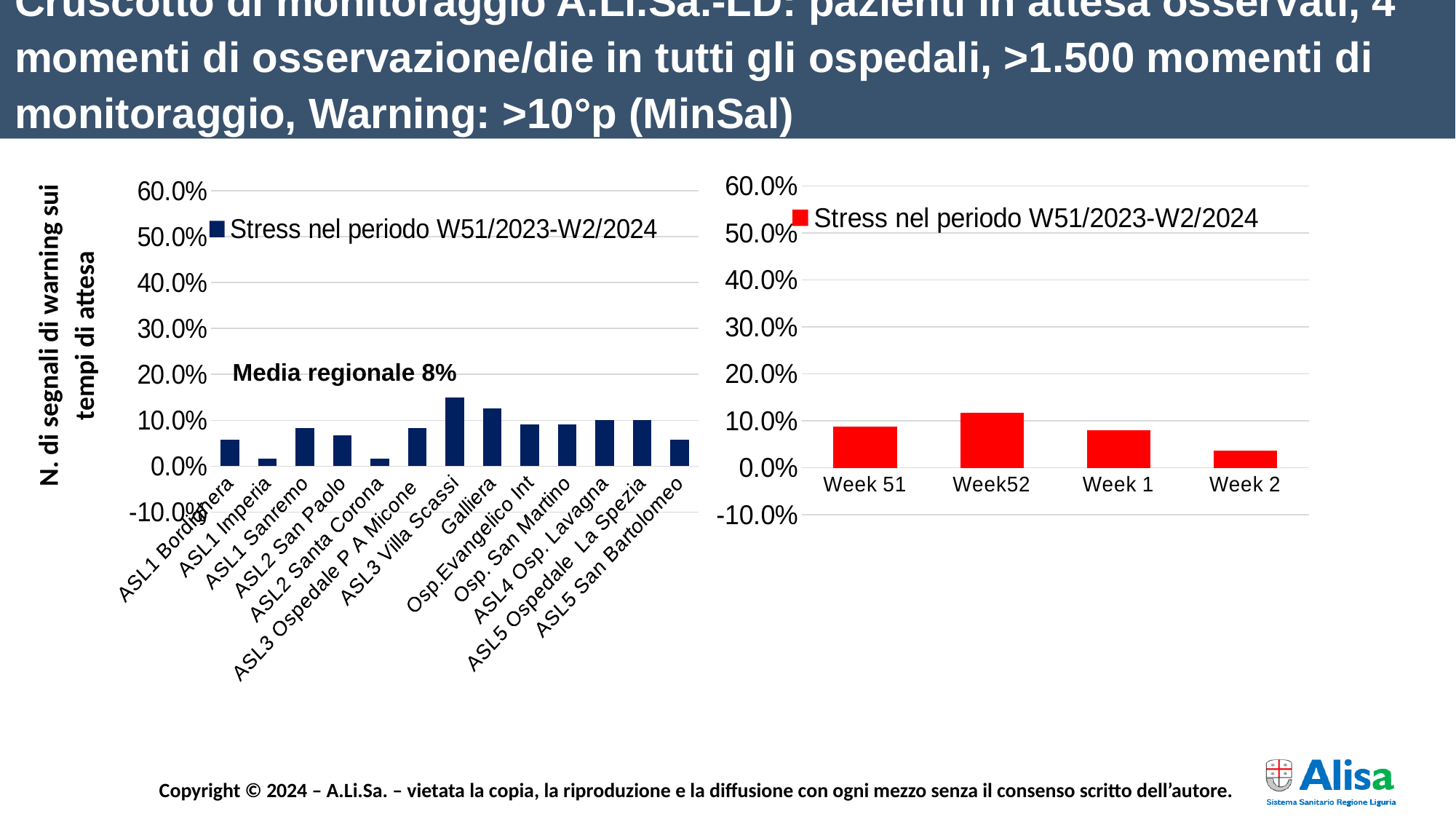
In the right chart (by week), which week has the lowest value? Week 2 In the right chart (by week), which week has the highest value? Week52 In the left chart (by hospital), which is larger, the value for ASL3 Villa Scassi or the value for ASL1 Bordighera? ASL3 Villa Scassi In the left chart (by hospital), is the value for Galliera greater or less than 10.0%? greater In the right chart (by week), how many series does the legend list? 1 What kind of chart is the left chart showing stress by hospital? bar chart In the left chart (by hospital), how many hospitals are shown on the x axis? 13 In the left chart (by hospital), which hospital has the highest value? ASL3 Villa Scassi In the left chart (by hospital), is the value for ASL1 Imperia greater or less than 10.0%? less In the right chart (by week), is the value for Week 2 greater or less than 10.0%? less In the right chart (by week), how many weeks are shown? 4 In the left chart (by hospital), what regional average is stated in the annotation? 8%